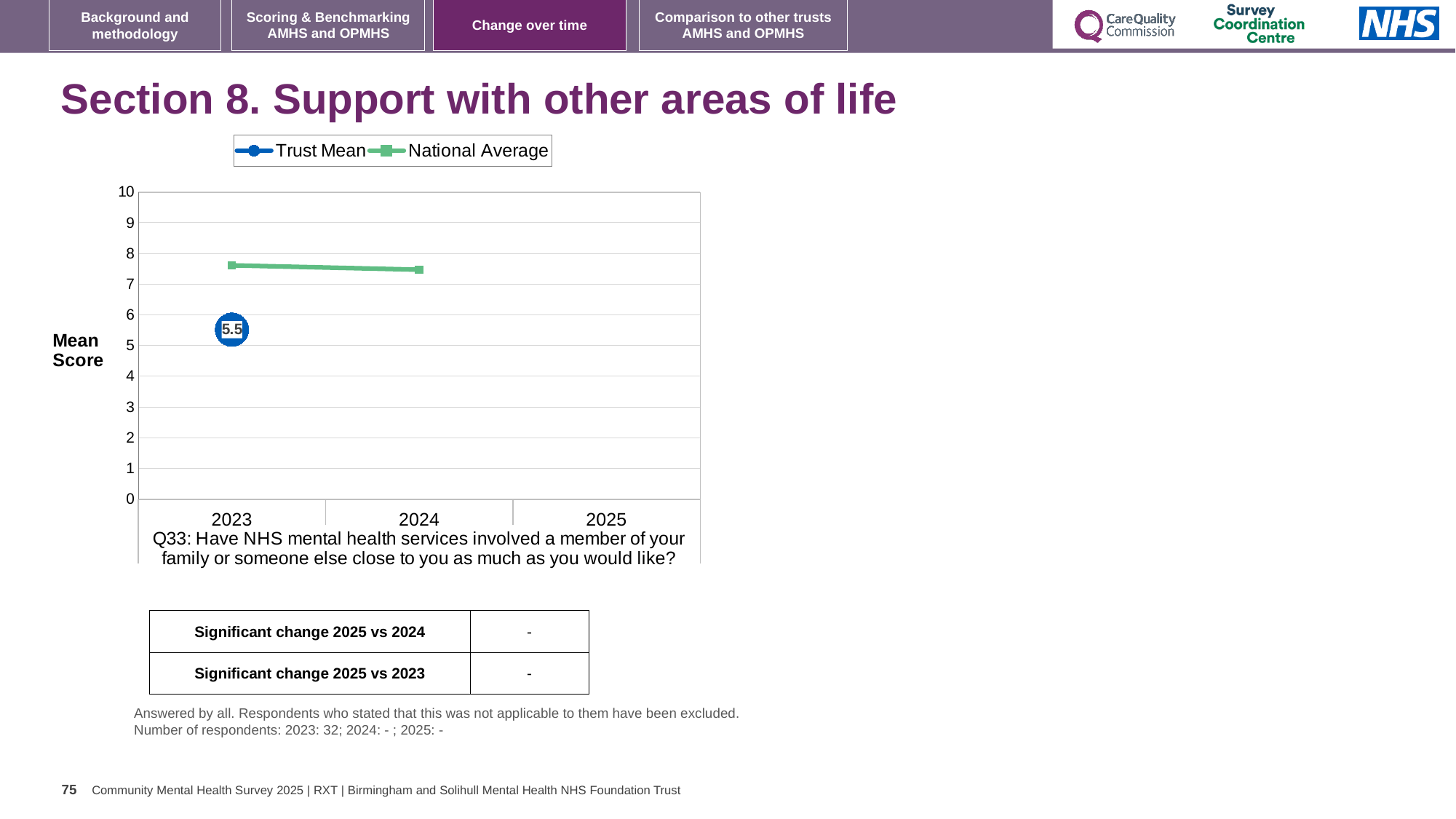
Is the National Average value for 2023 greater or less than 7? greater What kind of chart is shown on the slide? Line chart What are the two series named in the legend? Trust Mean and National Average Does the National Average rise or fall from 2023 to 2024? Fall In 2023, which is larger: the Trust Mean or the National Average? National Average How many series does the legend list? 2 Is the Trust Mean value for 2023 greater or less than 6? less How many years are shown on the x axis? 3 Is the National Average value for 2024 greater or less than 8? less For which year is a Trust Mean data point plotted? 2023 What is the Trust Mean value for 2023? 5.5 What is the label on the y axis of the chart? Mean Score